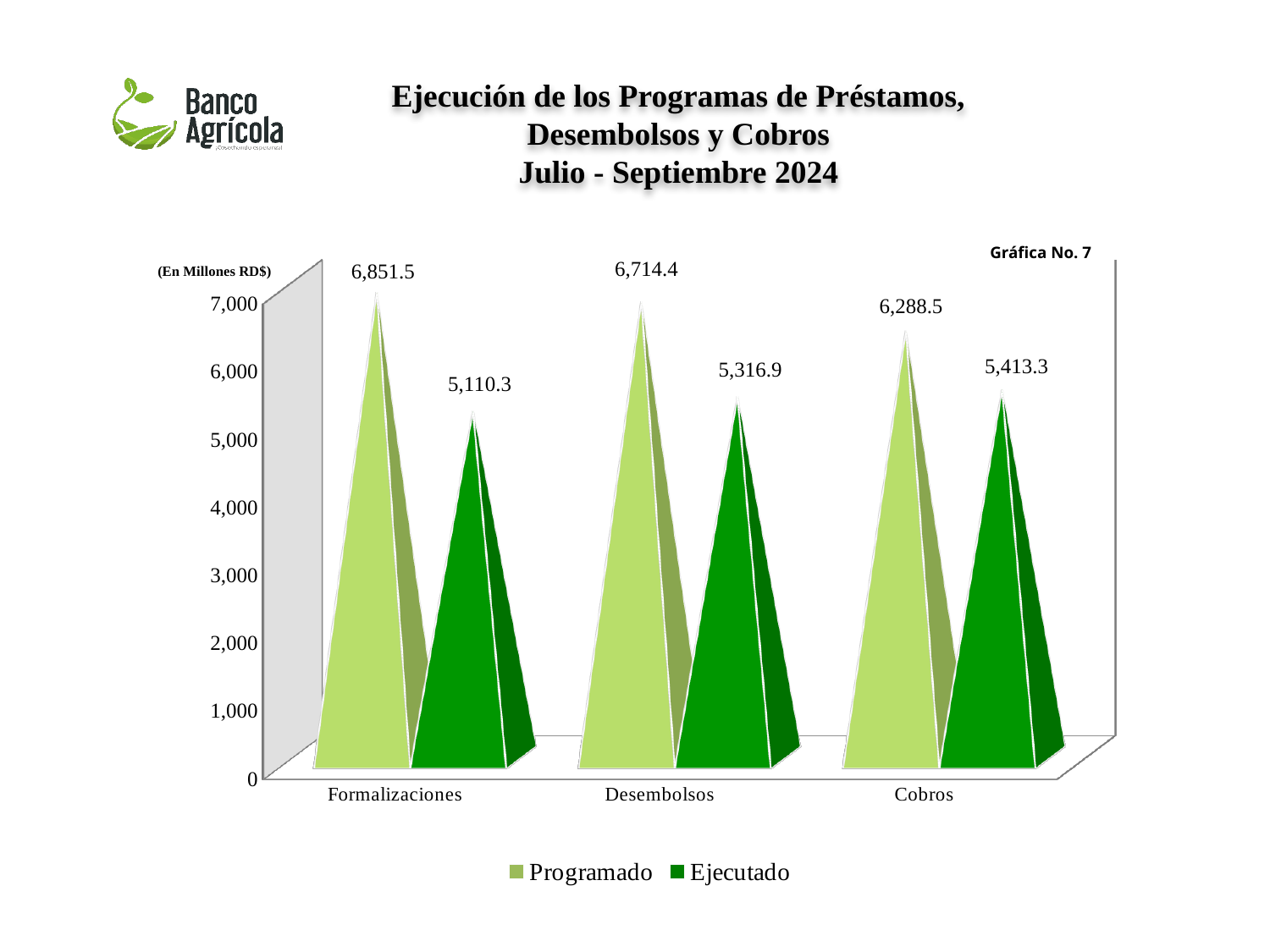
How many series does the legend list? 2 What is the difference between the Programado and Ejecutado values for Cobros? 875.2 Which category has the lowest Ejecutado value? Formalizaciones Is the Programado value for Cobros greater or less than 6,000? greater What is the Ejecutado value for Cobros? 5,413.3 Which category has the highest Programado value? Formalizaciones Does the Programado value rise or fall from Formalizaciones to Cobros? fall What unit is stated for the values in the chart? En Millones RD$ Which is larger: the Ejecutado value for Desembolsos or the Ejecutado value for Cobros? Ejecutado for Cobros What is the Ejecutado value for Desembolsos? 5,316.9 How many categories are shown on the x axis? 3 What is the Programado value for Formalizaciones? 6,851.5